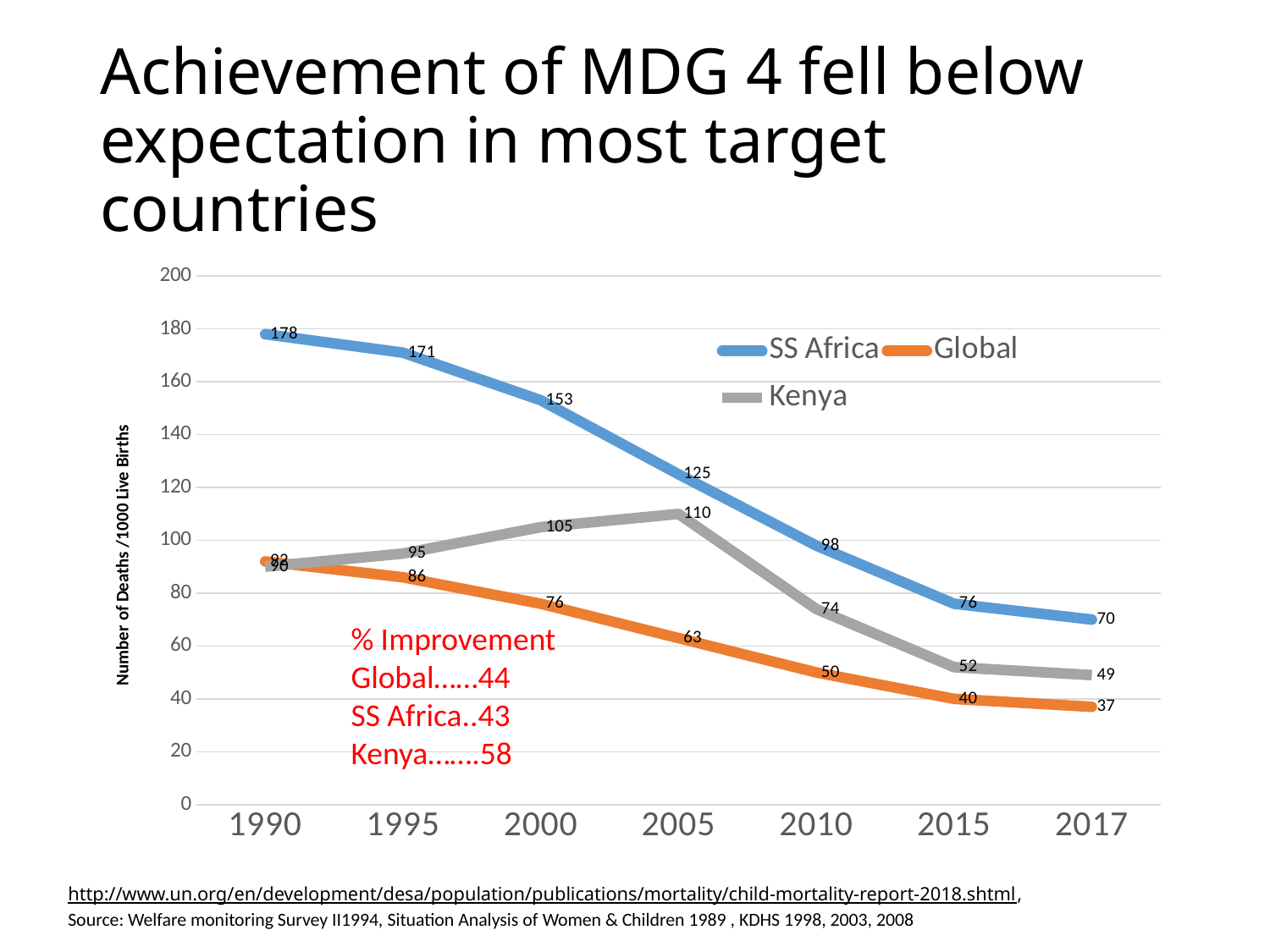
What type of chart is shown on the slide? line chart What is the value for SS Africa in 1990? 178 In which year is the Kenya value highest? 2005 How many years are shown on the x axis? 7 How many series does the legend list? 3 What is the value for Global in 2017? 37 What is the value for Kenya in 2005? 110 What is the difference between the SS Africa value and the Global value in 2015? 36 In which year is the SS Africa value lowest? 2017 Does the SS Africa series rise or fall from 1990 to 2017? fall Which is larger in 2000, the Kenya value or the Global value? Kenya What is the value for SS Africa in 2010? 98